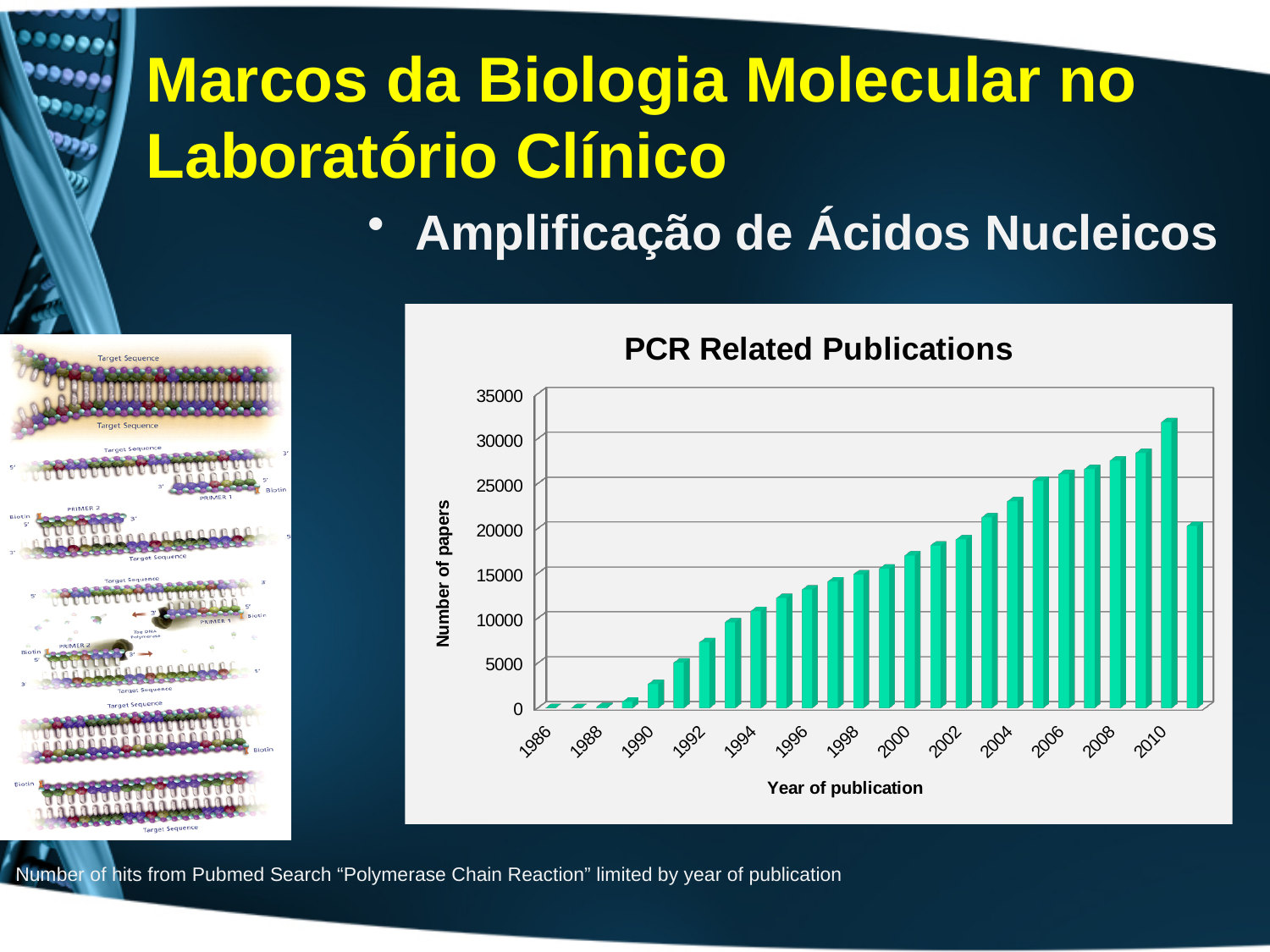
Is the value for 2008 greater or less than 30000? less What is the title of the chart? PCR Related Publications What kind of chart is shown on the slide? bar chart What is the label of the vertical axis of the chart? Number of papers Is the value for 2010 greater or less than 30000? greater Is the value for 2000 greater or less than 15000? greater Do the number of papers generally rise or fall from 1986 to 2010? rise Which year has more papers, 2010 or 2000? 2010 Which year has the highest number of papers in the chart? 2010